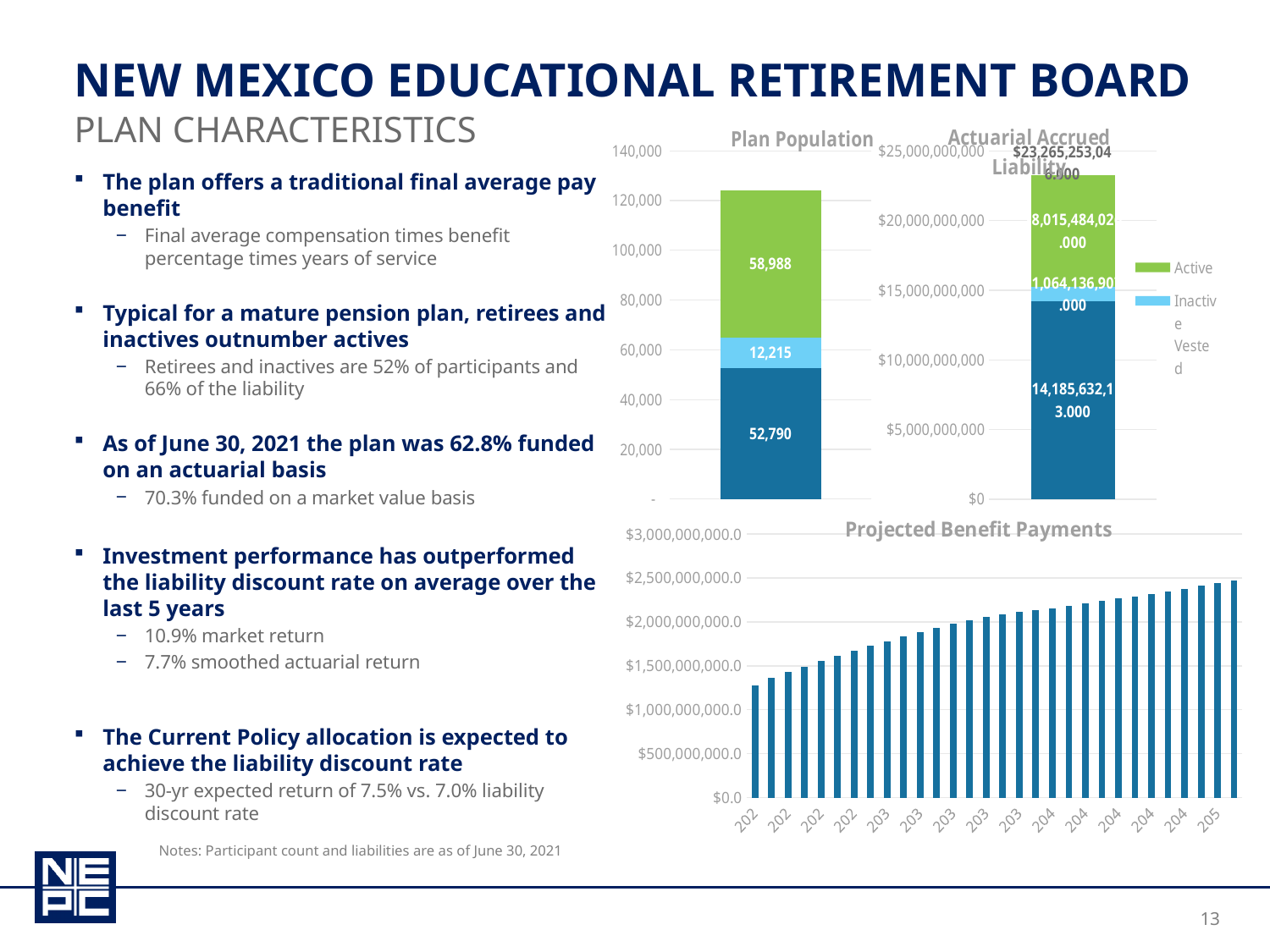
In the Plan Population chart, is the Active segment larger or smaller than the Inactive Vested segment? Larger In the Plan Population chart, what is the difference between the Active segment and the Inactive Vested segment? 46,773 In the Plan Population chart, which colour represents the Active series in the legend? Green In the Plan Population chart, what is the value of the bottom (dark blue) segment of the bar? 52,790 In the Plan Population chart, what is the value of the Inactive Vested segment? 12,215 In the Plan Population chart, what is the value of the Active segment? 58,988 In the Plan Population chart, what is the total of the stacked bar? 123,993 What kind of chart is the Projected Benefit Payments chart? Bar chart In the Projected Benefit Payments chart, is the value of the first (leftmost) bar greater or less than $1,500,000,000.0? less In the Plan Population chart, which labelled segment has the smallest value? Inactive Vested (12,215) In the Plan Population chart, which labelled segment has the largest value? Active (58,988) In the Projected Benefit Payments chart, do the values rise or fall from left to right along the x axis? Rise